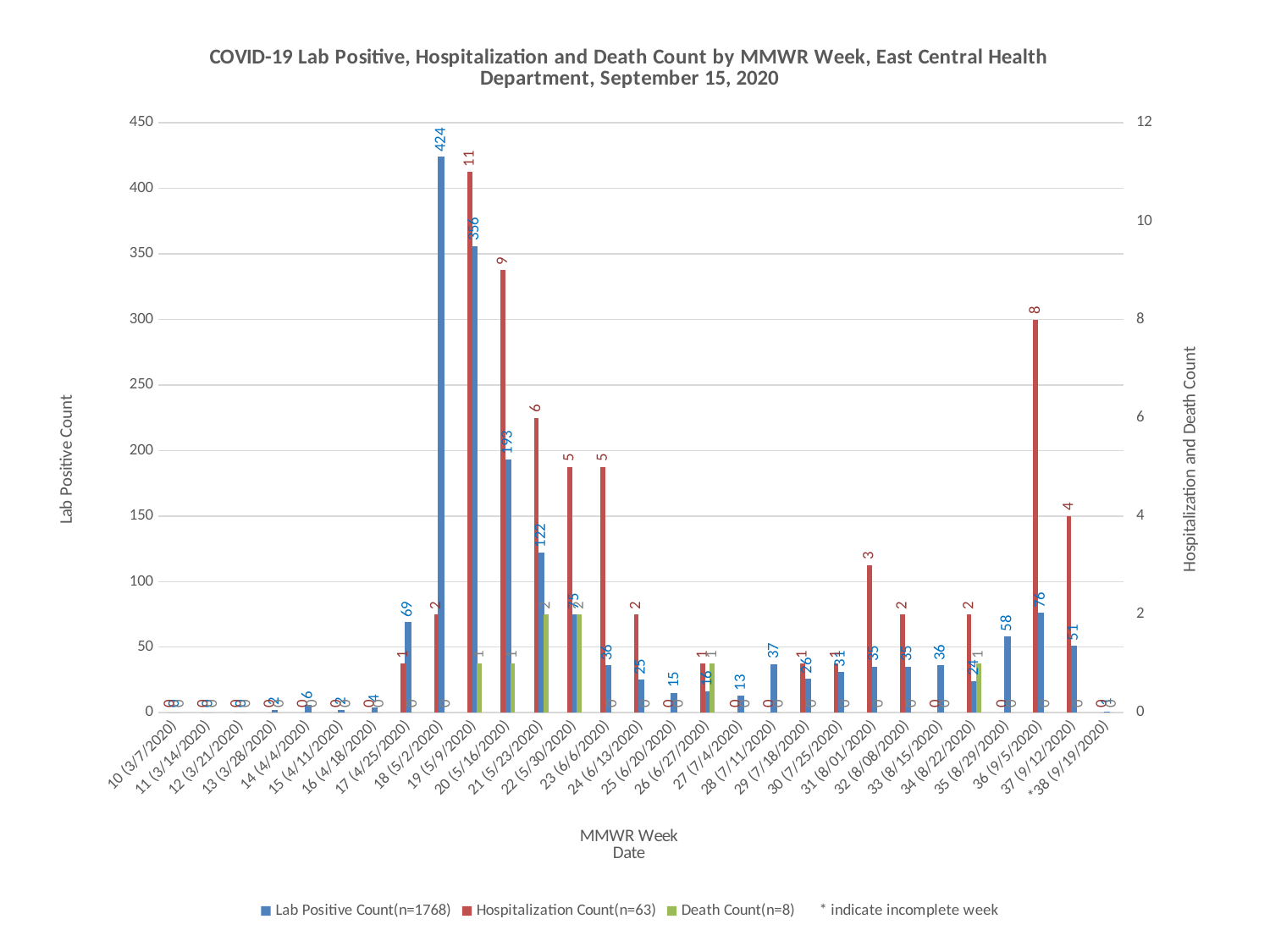
Which MMWR week has the highest Hospitalization Count? 19 (5/9/2020) How many MMWR weeks are shown on the x axis? 29 What is the Lab Positive Count for MMWR week 18 (5/2/2020)? 424 Which week has the larger Hospitalization Count, 36 (9/5/2020) or 37 (9/12/2020)? 36 (9/5/2020) What is the title of the right-hand vertical axis? Hospitalization and Death Count What kind of chart is shown on the slide? Bar chart Which MMWR week has the highest Lab Positive Count? 18 (5/2/2020) How many series does the legend list? 3 What is the difference between the Lab Positive Count for week 18 (5/2/2020) and week 19 (5/9/2020)? 68 What is the Hospitalization Count for MMWR week 19 (5/9/2020)? 11 What is the Death Count for MMWR week 21 (5/23/2020)? 2 What is the Lab Positive Count for MMWR week 36 (9/5/2020)? 76